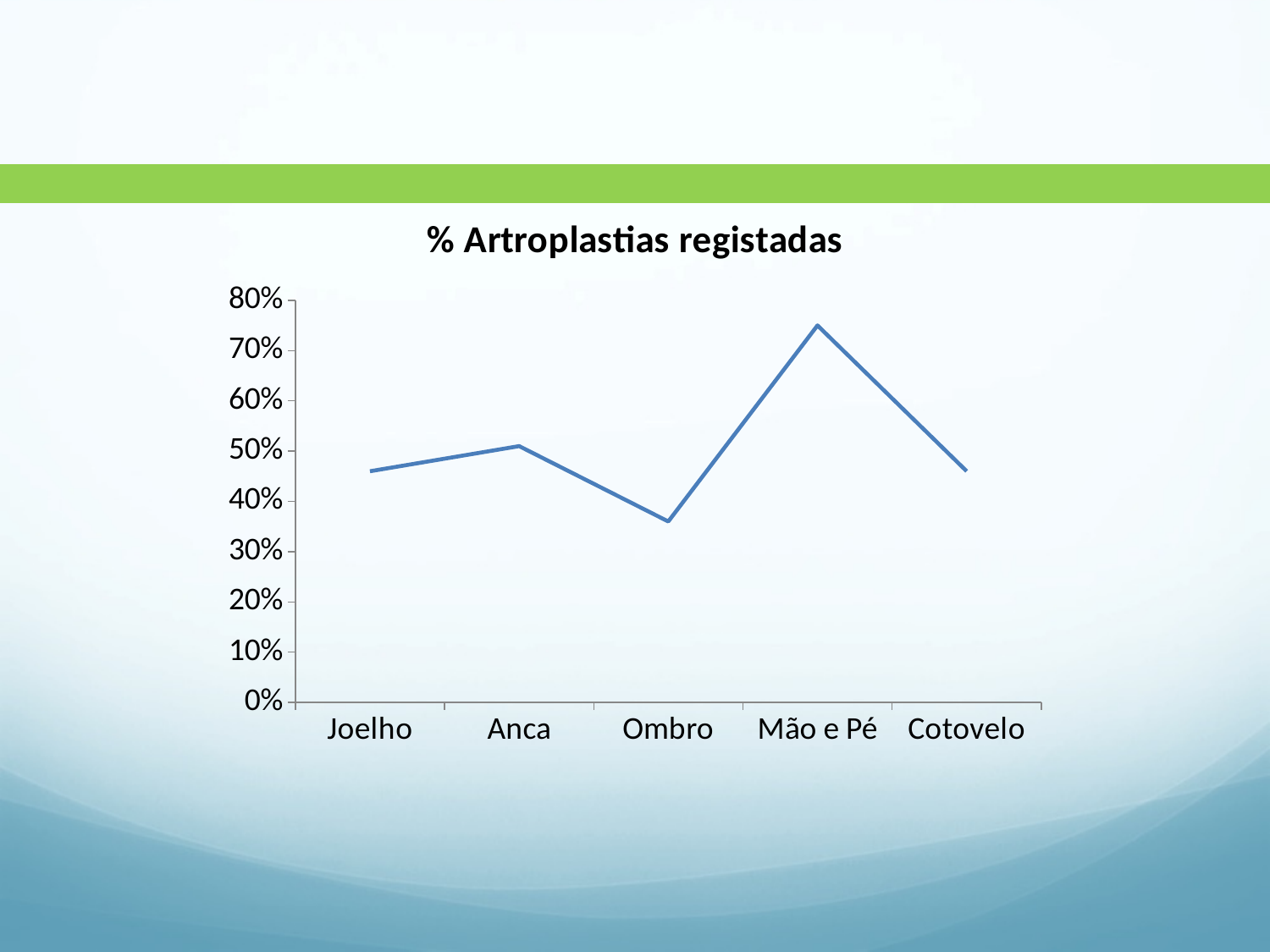
Does the line rise or fall from Mão e Pé to Cotovelo? fall Which is larger, the value for Anca or the value for Ombro? Anca Is the value for Cotovelo greater or less than 50%? less Which category has the lowest value? Ombro What is the title of the chart? % Artroplastias registadas What kind of chart is shown on the slide? line chart Is the value for Joelho greater or less than 40%? greater Which category has the highest value? Mão e Pé Is the value for Mão e Pé greater or less than 70%? greater How many categories are shown on the x axis? 5 Does the line rise or fall from Ombro to Mão e Pé? rise